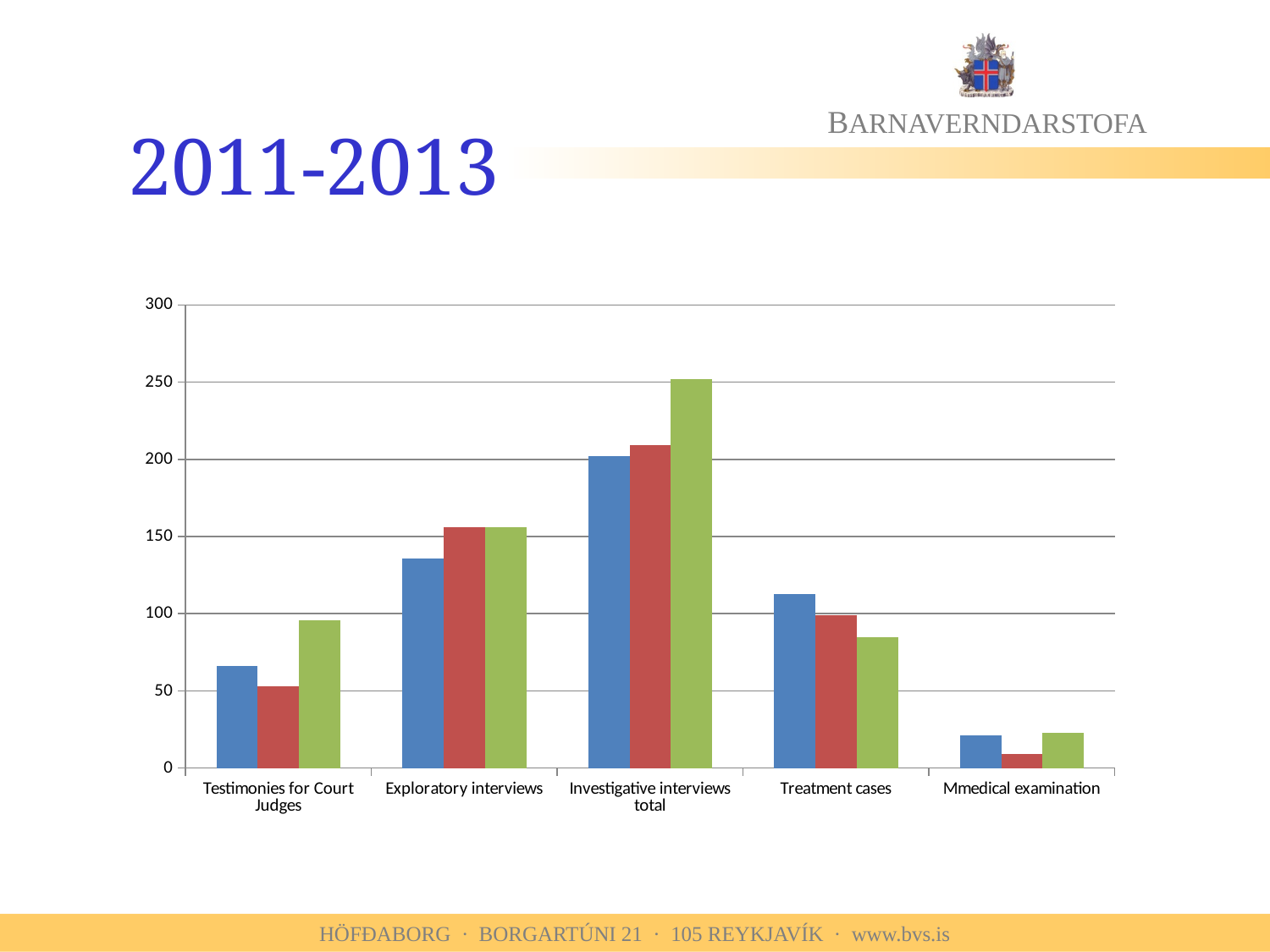
Is the blue bar for Exploratory interviews greater or less than 150? less For Testimonies for Court Judges, which is larger: the red bar or the green bar? the green bar Which category has the tallest bars in the chart? Investigative interviews total How many categories are shown on the x axis of the chart? 5 What is the title shown above the chart on the slide? 2011-2013 Which category has the shortest bars in the chart? Mmedical examination Is the green bar for Investigative interviews total greater or less than 200? greater Is the blue bar for Treatment cases greater or less than 100? greater How many bars are shown for each category in the chart? 3 What kind of chart is shown on the slide? bar chart For Treatment cases, which is larger: the blue bar or the green bar? the blue bar